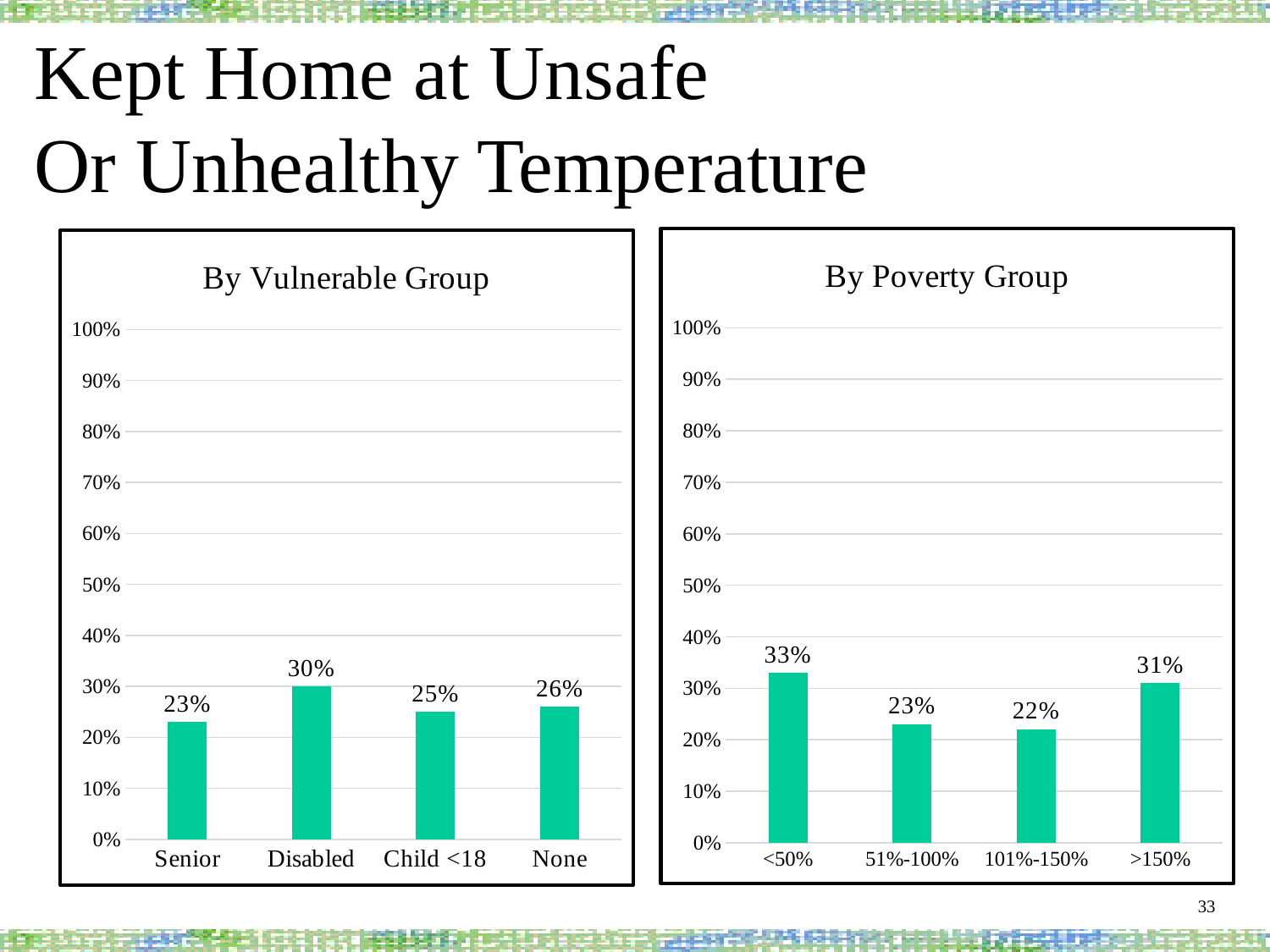
In the 'By Poverty Group' chart, which is larger, the value for <50% or the value for 51%-100%? <50% In the 'By Vulnerable Group' chart, which category has the highest value? Disabled What kind of chart is the 'By Poverty Group' chart? Bar chart In the 'By Poverty Group' chart, what is the value for >150%? 31% In the 'By Vulnerable Group' chart, what is the value for Disabled? 30% In the 'By Vulnerable Group' chart, what is the value for Senior? 23% In the 'By Poverty Group' chart, what is the value for 101%-150%? 22% In the 'By Poverty Group' chart, which category has the highest value? <50% In the 'By Vulnerable Group' chart, how many categories are shown? 4 In the 'By Poverty Group' chart, what is the difference between the values for <50% and 101%-150%? 11% In the 'By Vulnerable Group' chart, what is the difference between the values for Disabled and Senior? 7% In the 'By Vulnerable Group' chart, which category has the lowest value? Senior